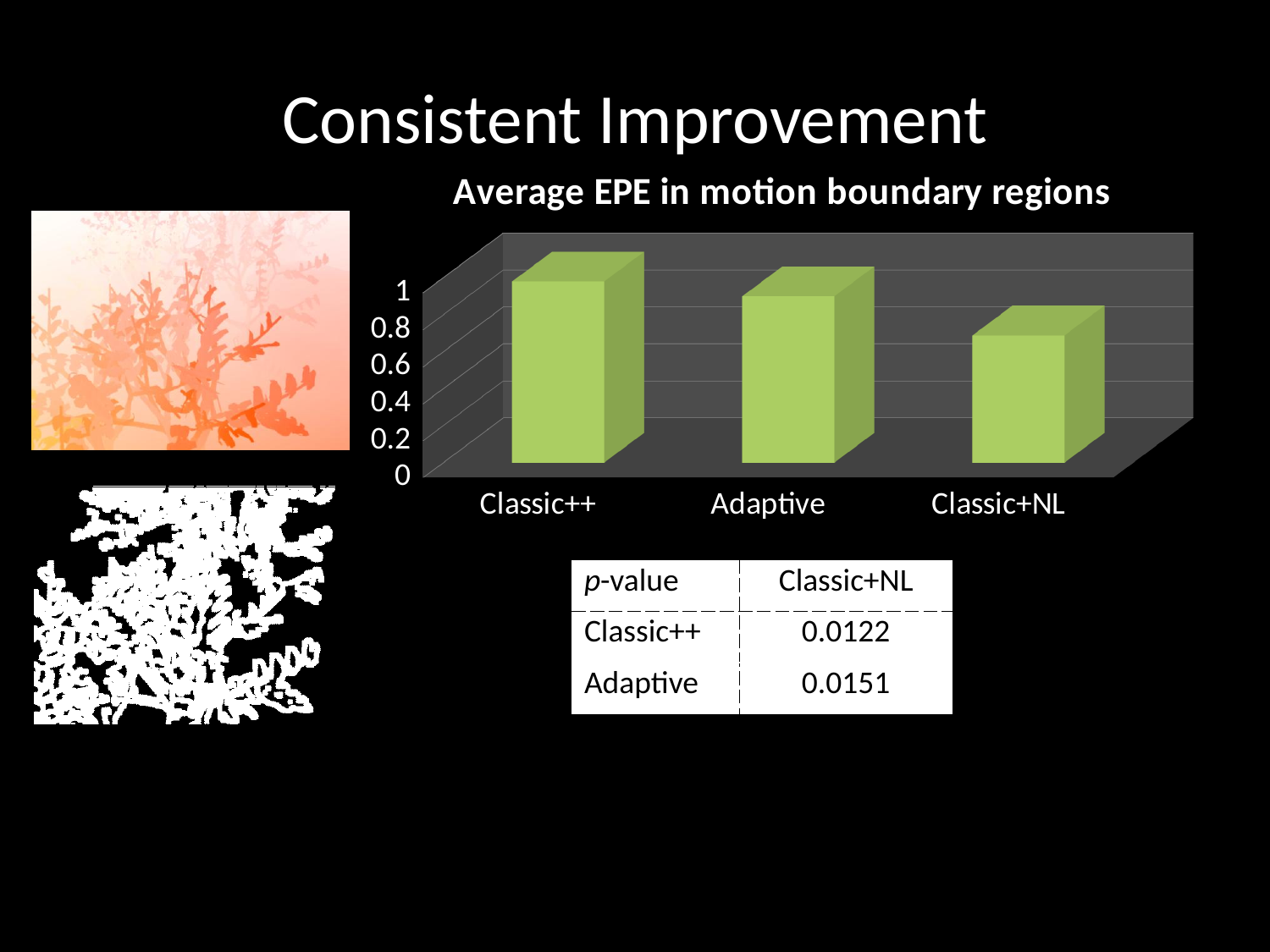
What is the title of the chart? Average EPE in motion boundary regions Do the bar values rise or fall from left to right across the categories? fall How many categories are plotted in the chart? 3 Which has a larger value in the chart, Adaptive or Classic+NL? Adaptive Is the value for Classic++ greater or less than 0.6? greater Which category has the lowest average EPE in the chart? Classic+NL Is the value for Classic+NL greater or less than 0.4? greater What kind of chart is shown on the slide? bar chart What colour are the bars in the chart? green Which has a larger value in the chart, Classic++ or Adaptive? Classic++ Is the value for Adaptive greater or less than 0.6? greater Which category has the highest average EPE in the chart? Classic++